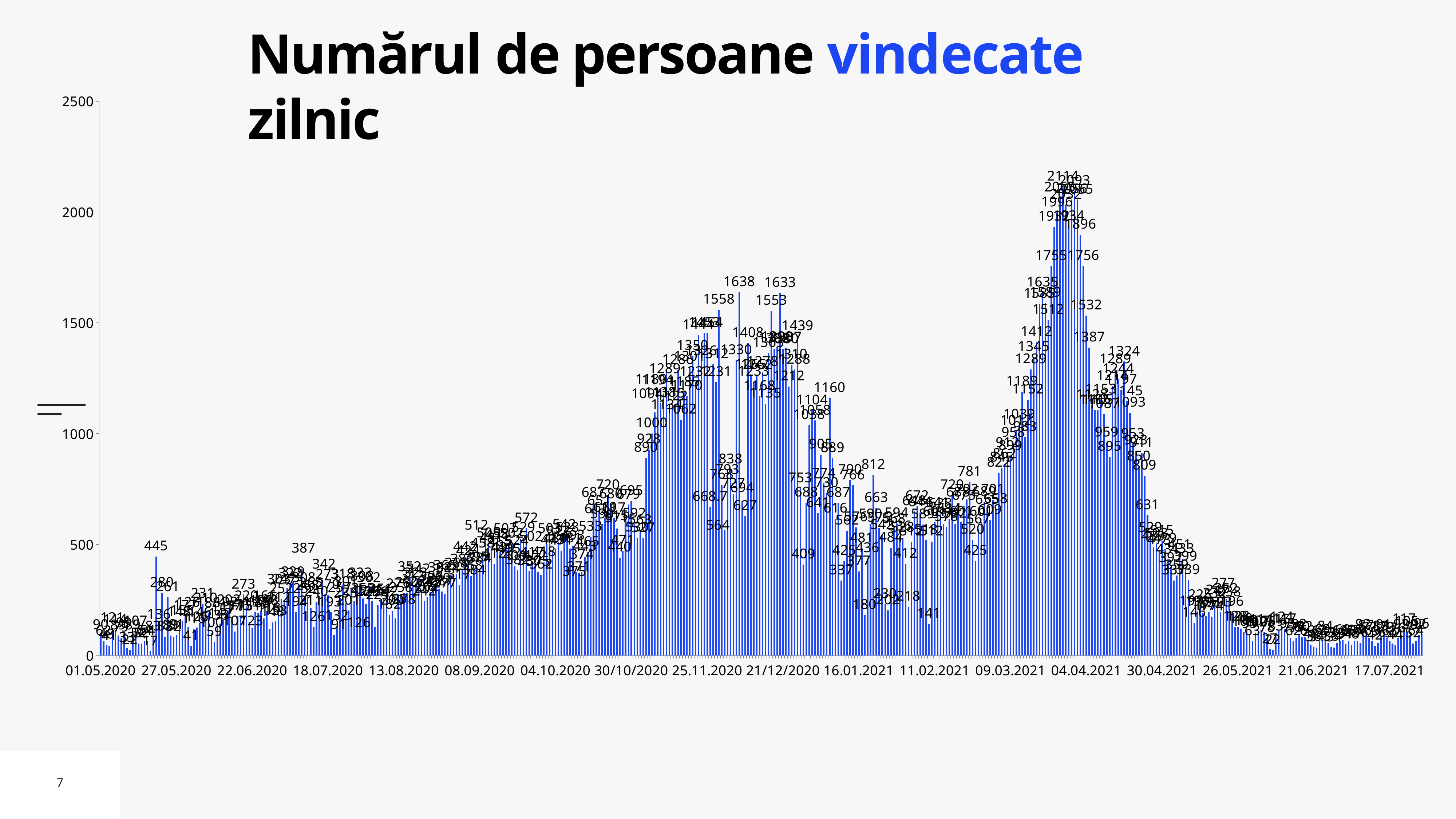
What is the title of the chart? Numărul de persoane vindecate zilnic Is the value at 16.01.2021 greater or less than 1000? less Is the value at 01.05.2020 greater or less than 500? less Do the values rise or fall between 04.04.2021 and 26.05.2021? fall Near which x-axis date label does the chart reach its highest peak? 04.04.2021 What kind of chart is shown on the slide? bar chart What is the highest daily value labelled on the chart? 2114 What is the maximum value shown on the vertical axis? 2500 Which peak is higher: the one around 21/12/2020 or the one around 04.04.2021? 04.04.2021 Is the value at 17.07.2021 greater or less than 500? less Do the values rise or fall between 09.03.2021 and 04.04.2021? rise